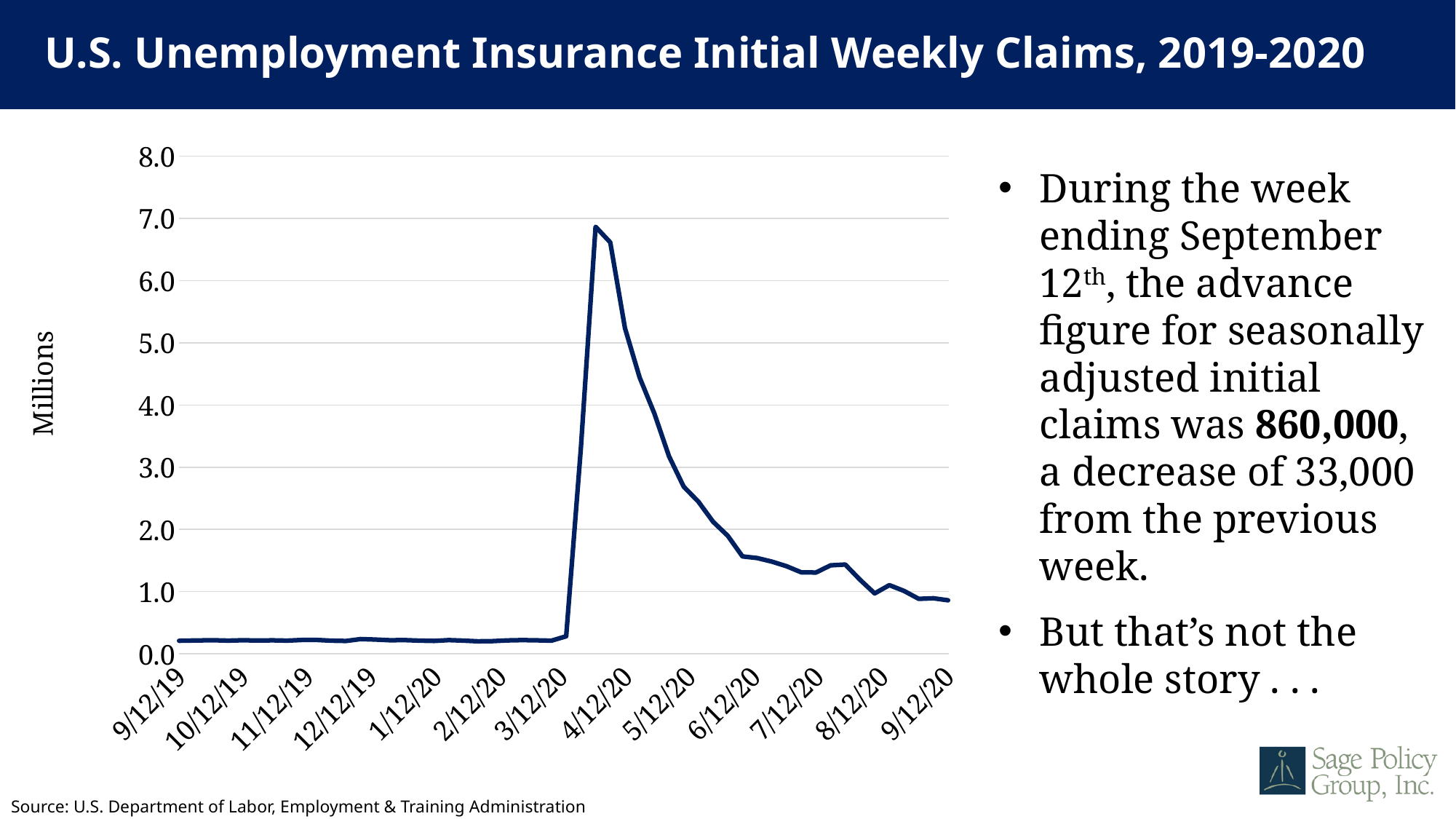
What is the title of the chart on the slide? U.S. Unemployment Insurance Initial Weekly Claims, 2019-2020 Which is larger, the value for 4/12/20 or the value for 9/12/19? 4/12/20 Is the value for 9/12/19 greater or less than 1.0? less Is the value for 6/12/20 greater or less than 2.0? less Do the values rise or fall along the x axis from 3/12/20 to 4/12/20? rise Which of the labeled dates on the x axis has the highest value? 4/12/20 What is the label on the vertical axis of the chart? Millions Do the values rise or fall along the x axis from 4/12/20 to 9/12/20? fall How many date labels are shown along the x axis of the chart? 13 What kind of chart is shown on the slide? line chart Is the value for 5/12/20 greater or less than 2.0? greater